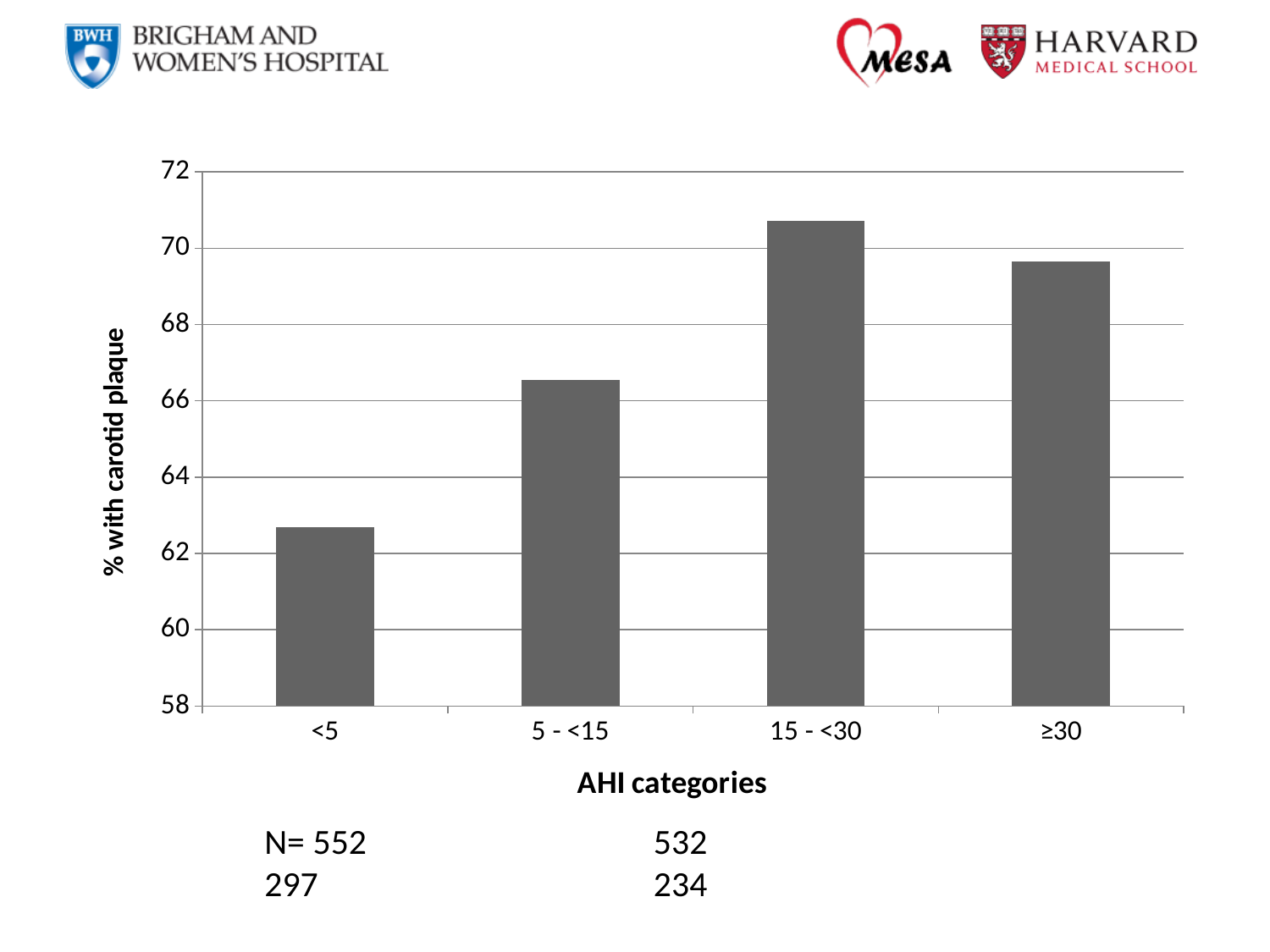
Which has a higher % with carotid plaque, the 5 - <15 category or the ≥30 category? ≥30 Is the value for the <5 AHI category greater or less than 64? less Which AHI category has the highest % with carotid plaque? 15 - <30 Is the value for the ≥30 AHI category greater or less than 70? less Which has a higher % with carotid plaque, the <5 category or the 5 - <15 category? 5 - <15 What is the title of the x axis of the chart? AHI categories Is the value for the 15 - <30 AHI category greater or less than 70? greater How many AHI categories are plotted on the chart? 4 Which AHI category has the lowest % with carotid plaque? <5 What kind of chart is shown on the slide? bar chart Do the values rise or fall from the <5 category to the 15 - <30 category? rise